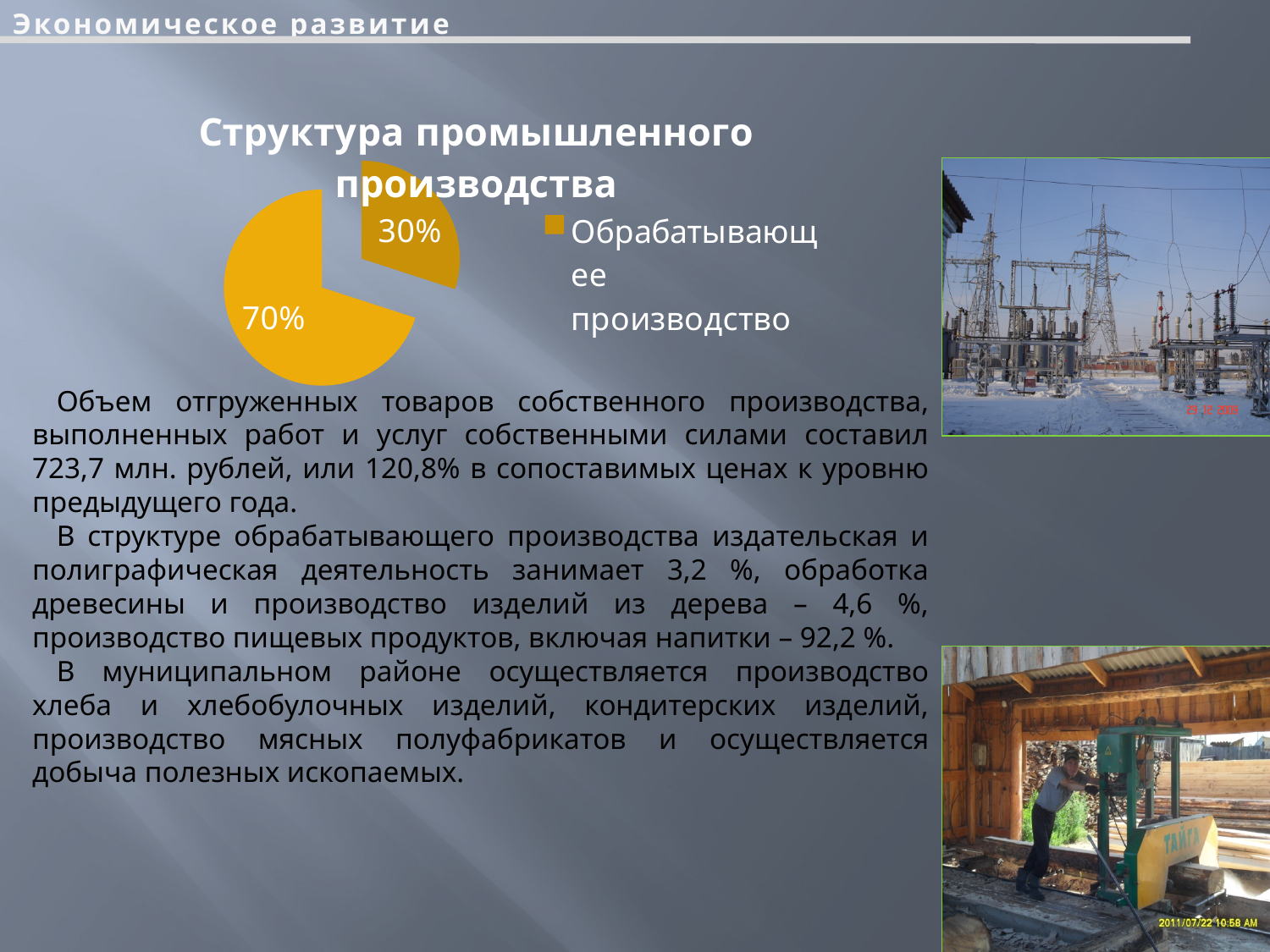
What is the title of the chart on the slide? Структура промышленного производства What is the value of the largest slice in the pie chart? 70% Do the two slices of the pie chart add up to 100%? yes How many slices does the pie chart have? 2 What kind of chart is shown on the slide? pie chart What is the difference between the two slices of the pie chart, in percentage points? 40 What share of the pie does the smaller, separated slice represent? 30% What share of the pie does the larger slice represent? 70% Which legend entry is readable next to the pie chart? Обрабатывающее производство What is the value of the smallest slice in the pie chart? 30% Which slice of the pie chart is larger, the one labelled 70% or the one labelled 30%? 70%